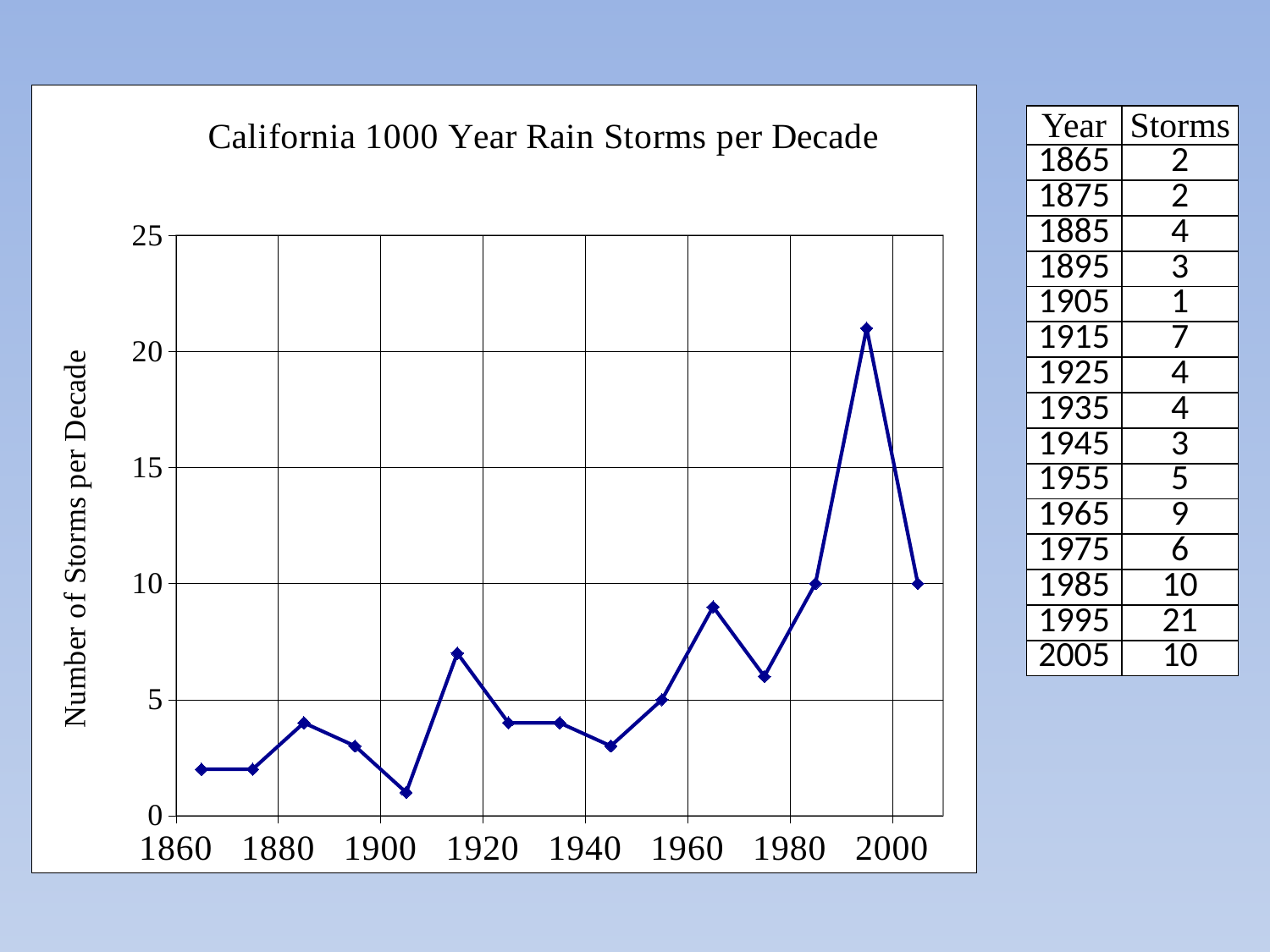
What is the title of the chart? California 1000 Year Rain Storms per Decade What is the difference in storms between 1995 and 2005? 11 Is the value for 1985 greater or less than 5? greater Which has more storms, 1965 or 1975? 1965 Which year has the lowest number of storms? 1905 How many data points are plotted on the chart? 15 Which year has the highest number of storms? 1995 How many storms are recorded for 1995? 21 What kind of chart is shown on the slide? line chart Do the values generally rise or fall from 1945 to 1995? rise What is the label on the vertical axis? Number of Storms per Decade How many storms are recorded for 1915? 7